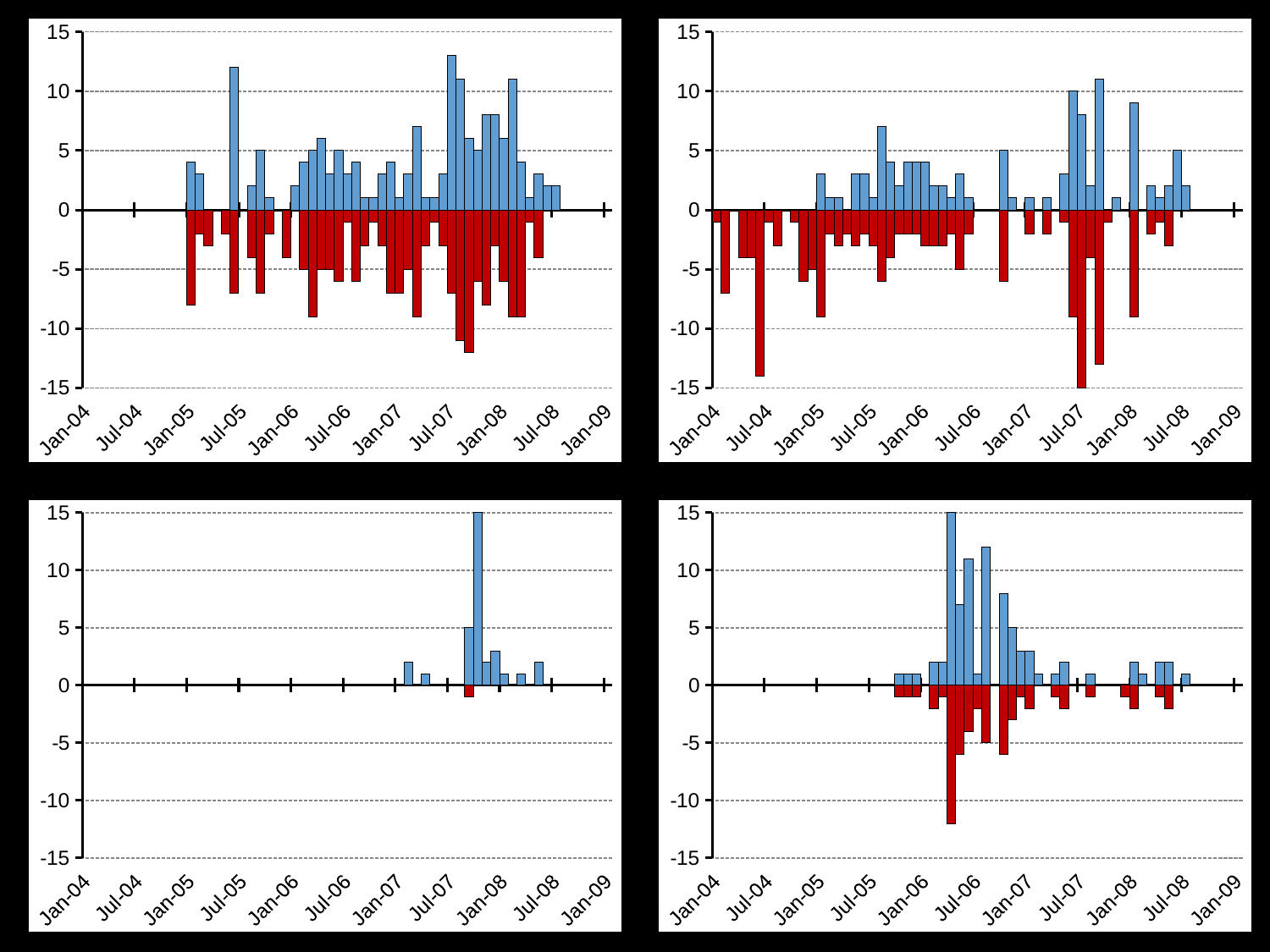
In the bottom-left chart, is the tallest blue bar greater or less than 10? greater How many labels are shown on the horizontal axis of the top-left chart? 11 In the bottom-right chart, is the tallest blue bar greater or less than 10? greater In the top-right chart, is the lowest red bar near Jul-04 greater or less than -10? less What kind of chart is the top-left chart? bar chart What is the highest value shown on the vertical axis of the charts? 15 Which chart has the taller maximum blue bar: the bottom-left chart or the top-right chart? bottom-left chart How many charts are shown on the slide? 4